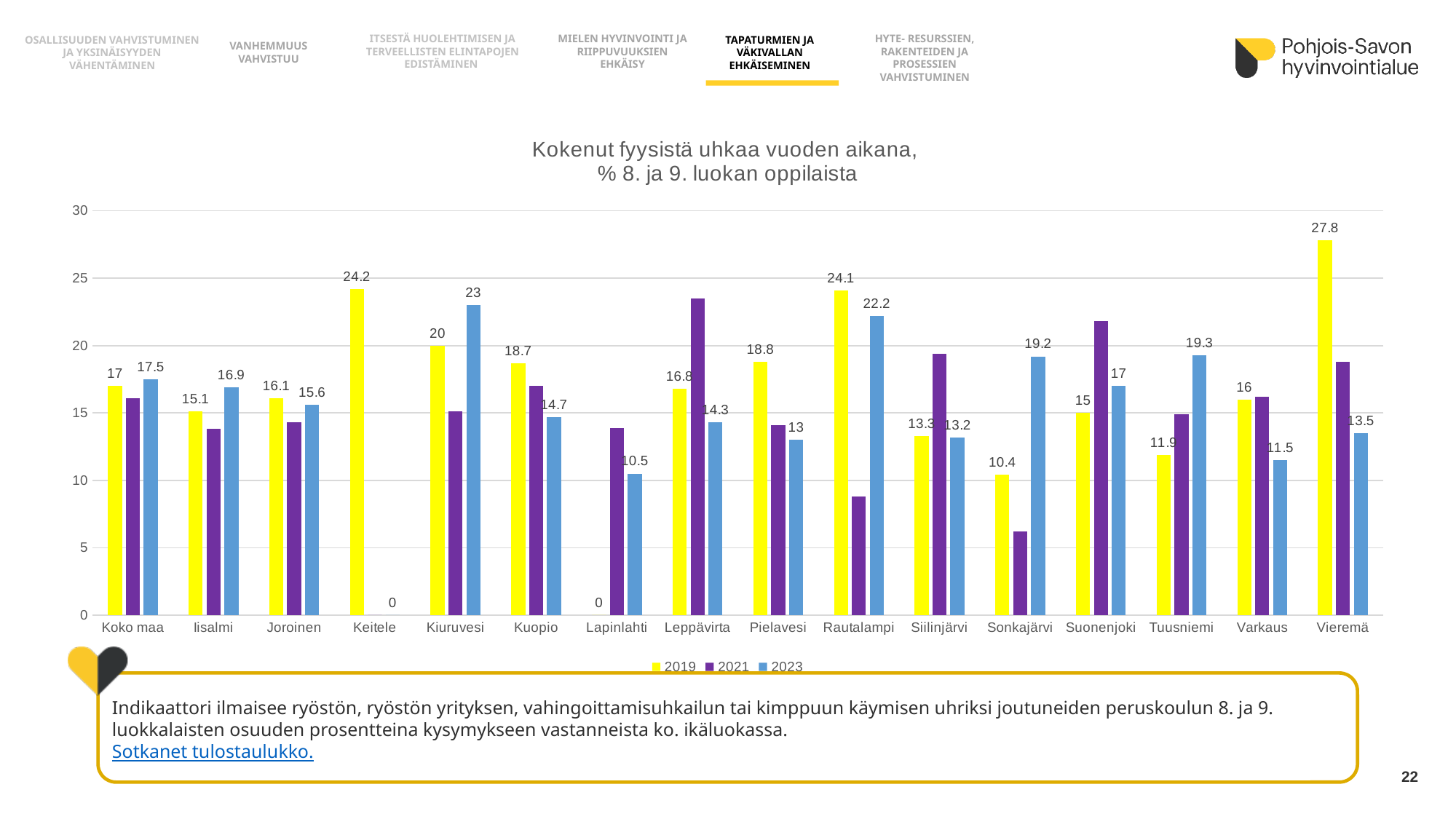
How many series does the legend list? 3 Is the 2021 value for Leppävirta greater or less than 20? greater What is the 2023 value for Kiuruvesi? 23 For Sonkajärvi, which is larger: the 2019 value or the 2023 value? 2023 Which category has the highest 2023 value? Kiuruvesi Which category has the highest 2019 value? Vieremä Is the 2021 value for Sonkajärvi greater or less than 10? less What is the 2019 value for Keitele? 24.2 How many categories are shown on the x axis? 16 What is the 2019 value for Vieremä? 27.8 What is the difference between the 2023 and 2019 values for Koko maa? 0.5 What is the difference between the 2019 and 2023 values for Rautalampi? 1.9